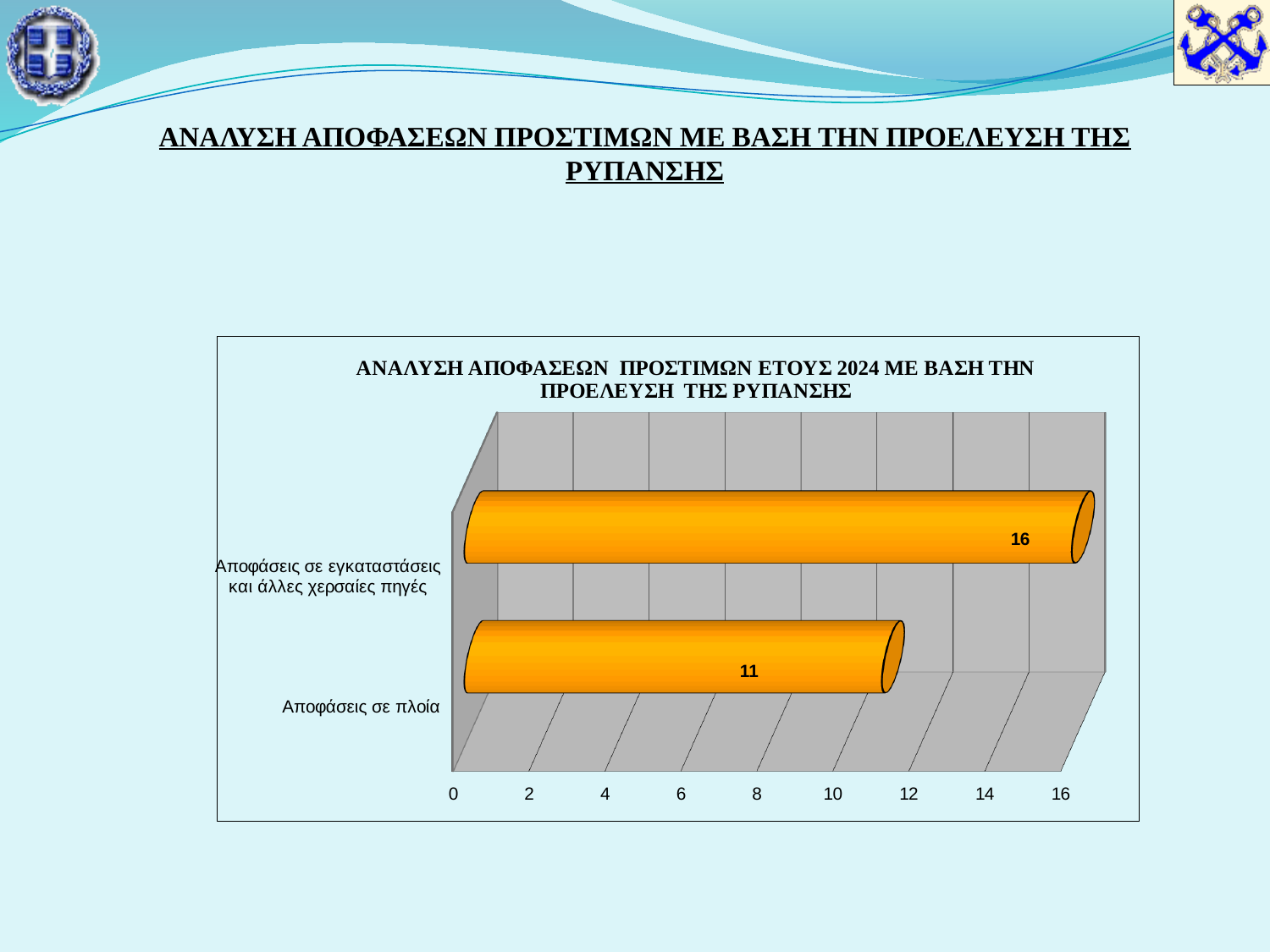
What kind of chart is shown on the slide? bar chart What is the difference between the value for "Αποφάσεις σε εγκαταστάσεις και άλλες χερσαίες πηγές" and the value for "Αποφάσεις σε πλοία"? 5 What is the title of the chart? ΑΝΑΛΥΣΗ ΑΠΟΦΑΣΕΩΝ ΠΡΟΣΤΙΜΩΝ ΕΤΟΥΣ 2024 ΜΕ ΒΑΣΗ ΤΗΝ ΠΡΟΕΛΕΥΣΗ ΤΗΣ ΡΥΠΑΝΣΗΣ What is the value for "Αποφάσεις σε εγκαταστάσεις και άλλες χερσαίες πηγές"? 16 What is the value for "Αποφάσεις σε πλοία"? 11 How many categories are shown in the chart? 2 Is the value for "Αποφάσεις σε εγκαταστάσεις και άλλες χερσαίες πηγές" greater or less than 14? greater Which is larger: the value for "Αποφάσεις σε πλοία" or the value for "Αποφάσεις σε εγκαταστάσεις και άλλες χερσαίες πηγές"? Αποφάσεις σε εγκαταστάσεις και άλλες χερσαίες πηγές Which category has the lowest value? Αποφάσεις σε πλοία Which category has the highest value? Αποφάσεις σε εγκαταστάσεις και άλλες χερσαίες πηγές Is the value for "Αποφάσεις σε πλοία" greater or less than 10? greater What is the maximum value shown on the horizontal axis of the chart? 16